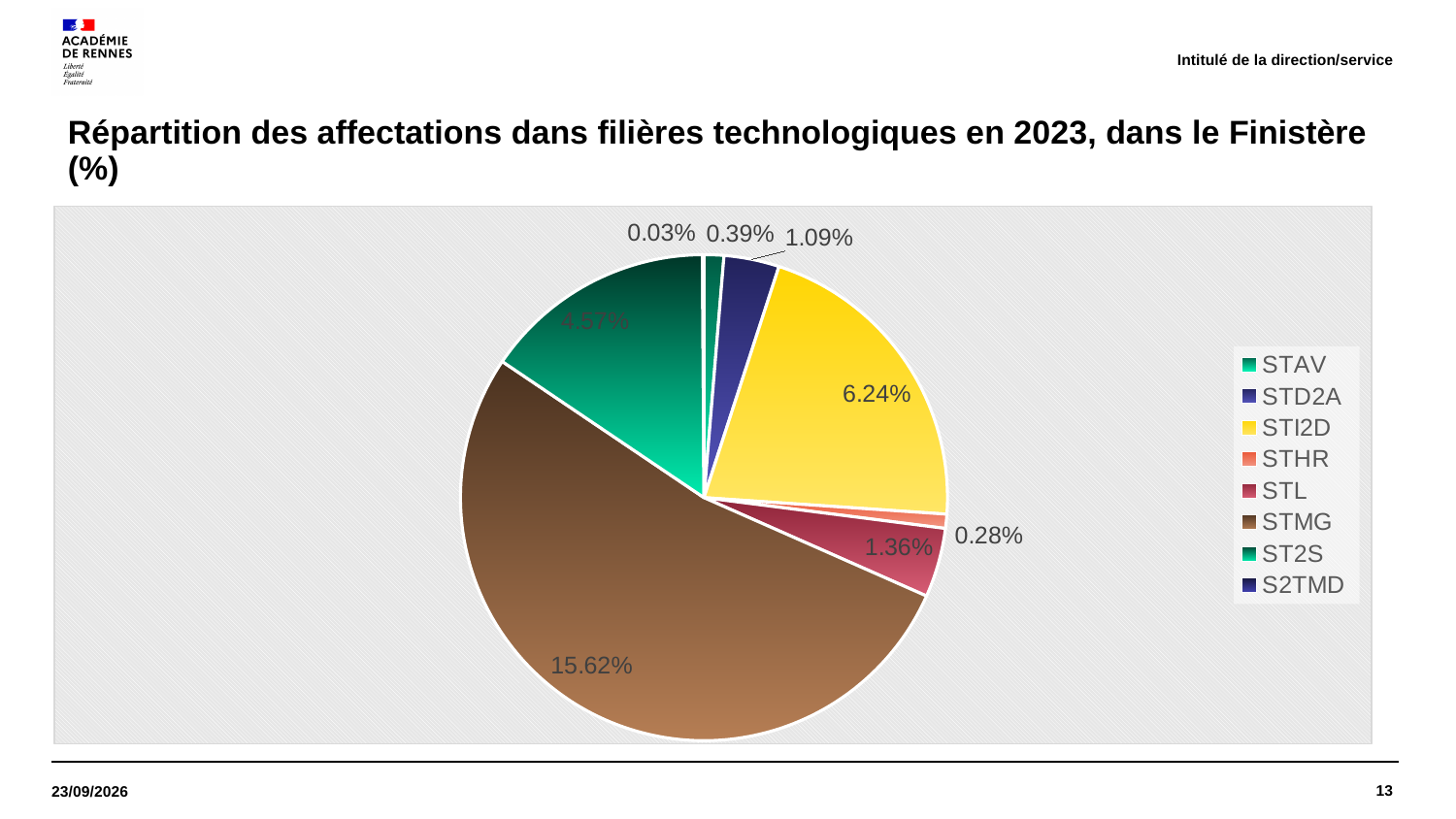
Which category has the largest slice of the pie? STMG What is the value shown for STHR? 0.28% What is the value shown for STL? 1.36% What is the value shown for ST2S? 4.57% What is the smallest value labelled on the pie chart? 0.03% What is the value shown for STD2A? 1.09% Which is larger, the value for ST2S or the value for STL? ST2S What is the value shown for STI2D? 6.24% What is the value shown for STMG? 15.62% How many categories does the legend of the pie chart list? 8 What kind of chart is shown on the slide? pie chart What is the difference between the values for STMG and STI2D? 9.38%